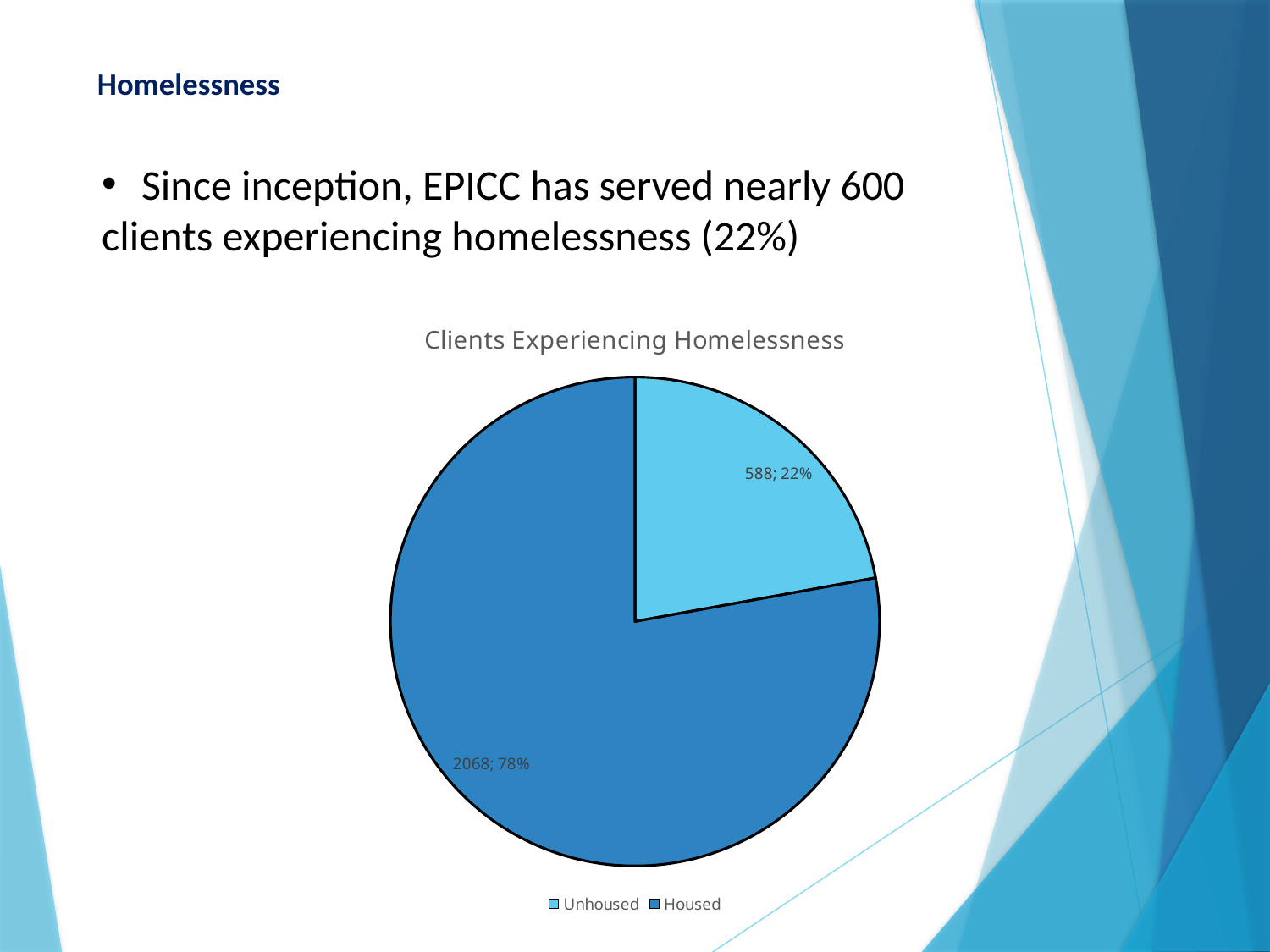
Which slice is the largest? Housed How many clients are in the Housed slice? 2068 What is the total number of clients across both slices? 2656 Which slice is the smallest? Unhoused What share of the pie is the Unhoused slice? 22% How many slices does the pie chart have? 2 What share of the pie is the Housed slice? 78% Which is larger, the Unhoused slice or the Housed slice? Housed What kind of chart is shown on the slide? pie chart How many clients are in the Unhoused slice? 588 What is the title of the chart? Clients Experiencing Homelessness What is the difference in clients between the Housed and Unhoused slices? 1480